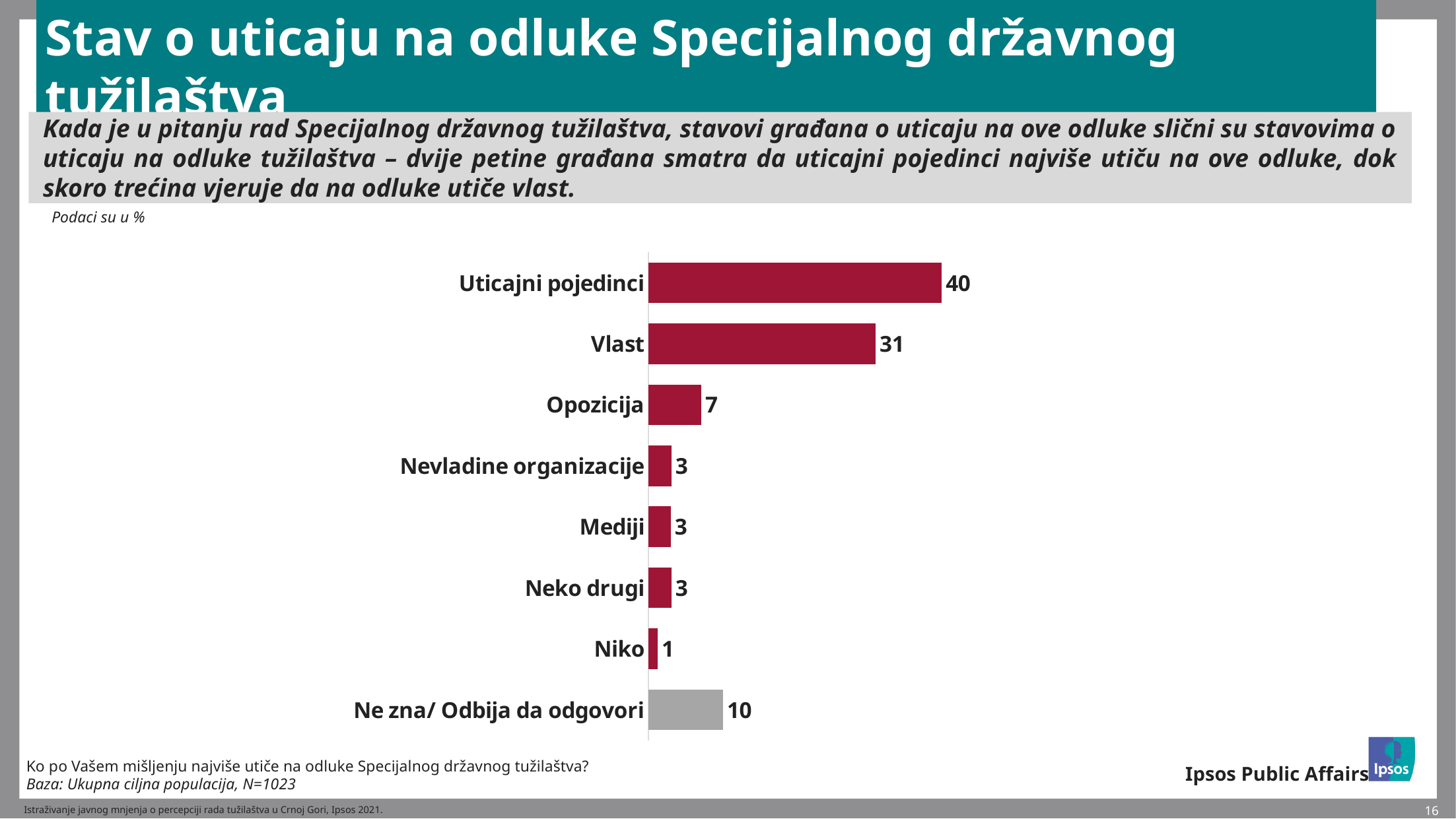
What is the value for Vlast? 31 Which category's bar is coloured grey rather than red? Ne zna/ Odbija da odgovori Which category has the lowest value? Niko What is the value for Mediji? 3 What is the difference between the values for Uticajni pojedinci and Vlast? 9 Which is larger, the value for Opozicija or the value for Ne zna/ Odbija da odgovori? Ne zna/ Odbija da odgovori What is the value for Opozicija? 7 How many categories are shown in the chart? 8 Which category has the highest value? Uticajni pojedinci What kind of chart is shown on the slide? Bar chart What is the value for Ne zna/ Odbija da odgovori? 10 What is the value for Uticajni pojedinci? 40